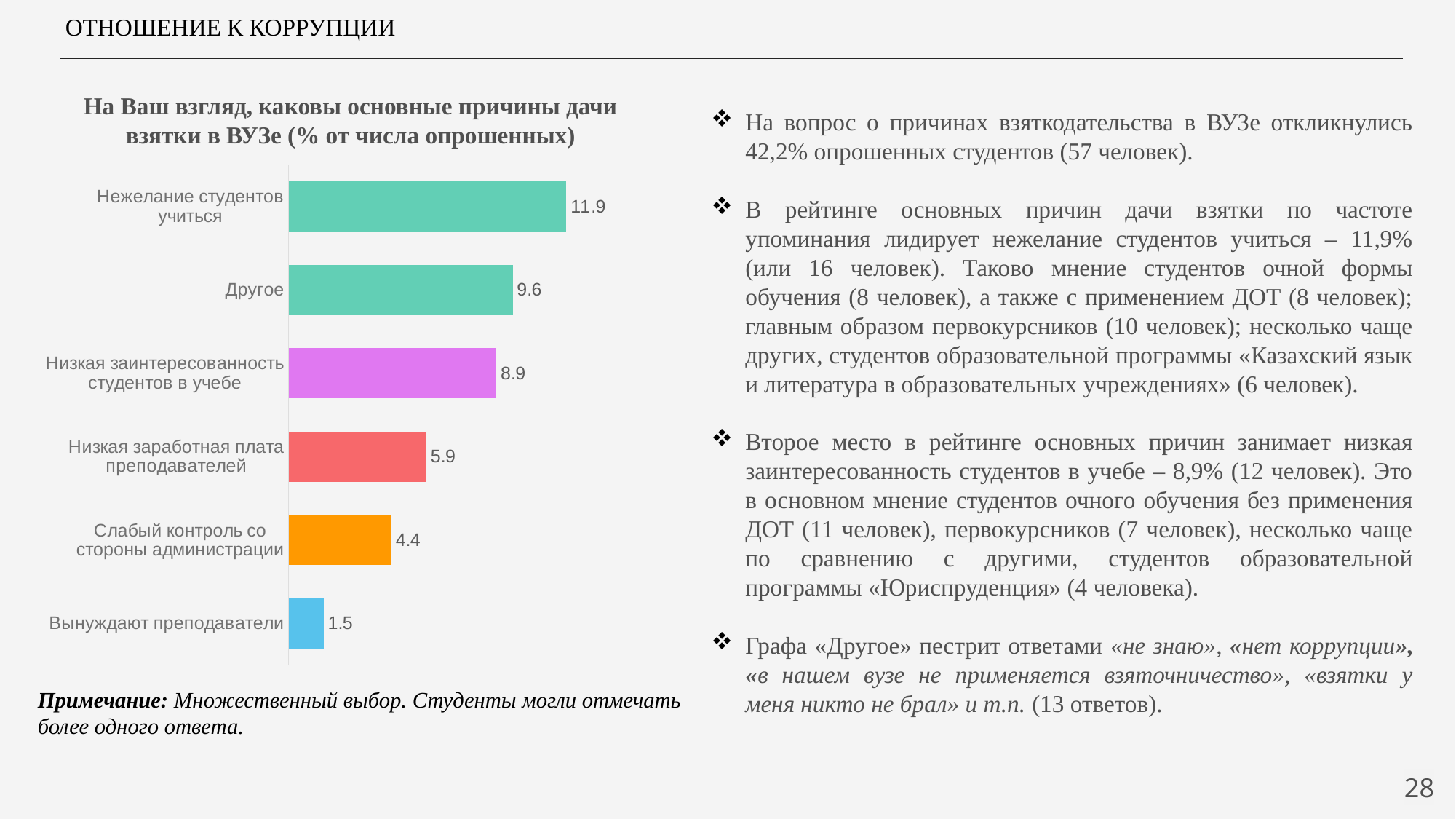
What is the value for «Нежелание студентов учиться»? 11.9 Which category has the highest value? Нежелание студентов учиться What is the difference between the values for «Нежелание студентов учиться» and «Вынуждают преподаватели»? 10.4 Which is larger: the value for «Низкая заработная плата преподавателей» or «Слабый контроль со стороны администрации»? Низкая заработная плата преподавателей Which category has the lowest value? Вынуждают преподаватели What colour is the bar for «Низкая заинтересованность студентов в учебе»? Purple What is the value for «Низкая заработная плата преподавателей»? 5.9 What is the value for «Другое»? 9.6 What is the value for «Слабый контроль со стороны администрации»? 4.4 How many categories are shown in the chart? 6 What kind of chart is shown on the slide? Bar chart What is the difference between the values for «Другое» and «Низкая заинтересованность студентов в учебе»? 0.7